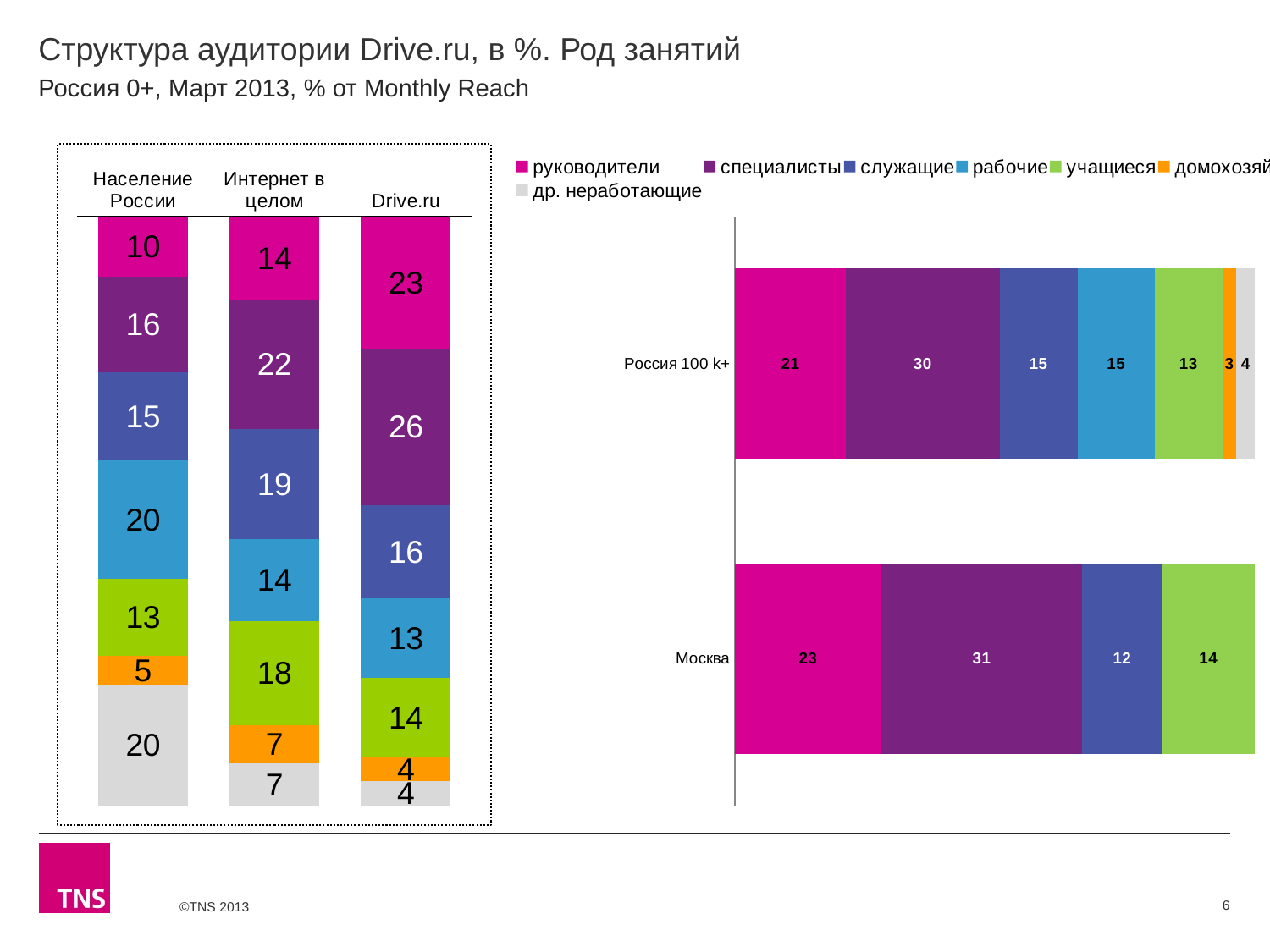
In the left chart, which column has the highest value for руководители? Drive.ru In the left chart, what is the value for специалисты in the Drive.ru column? 26 How many columns (categories) does the left chart show? 3 In the left chart, what is the value for учащиеся in the Интернет в целом column? 18 In the left chart, what is the value for рабочие in the Население России column? 20 In the right chart, what is the value for специалисты for Москва? 31 In the left chart, which column has the lowest value for др. неработающие? Drive.ru How many series does the legend list? 7 In the right chart, which is larger: the служащие value for Россия 100 k+ or for Москва? Россия 100 k+ In the left chart, what is the difference between the руководители values for Drive.ru and Население России? 13 What type of chart is the right chart? Stacked bar chart In the right chart, what is the value for руководители for Россия 100 k+? 21